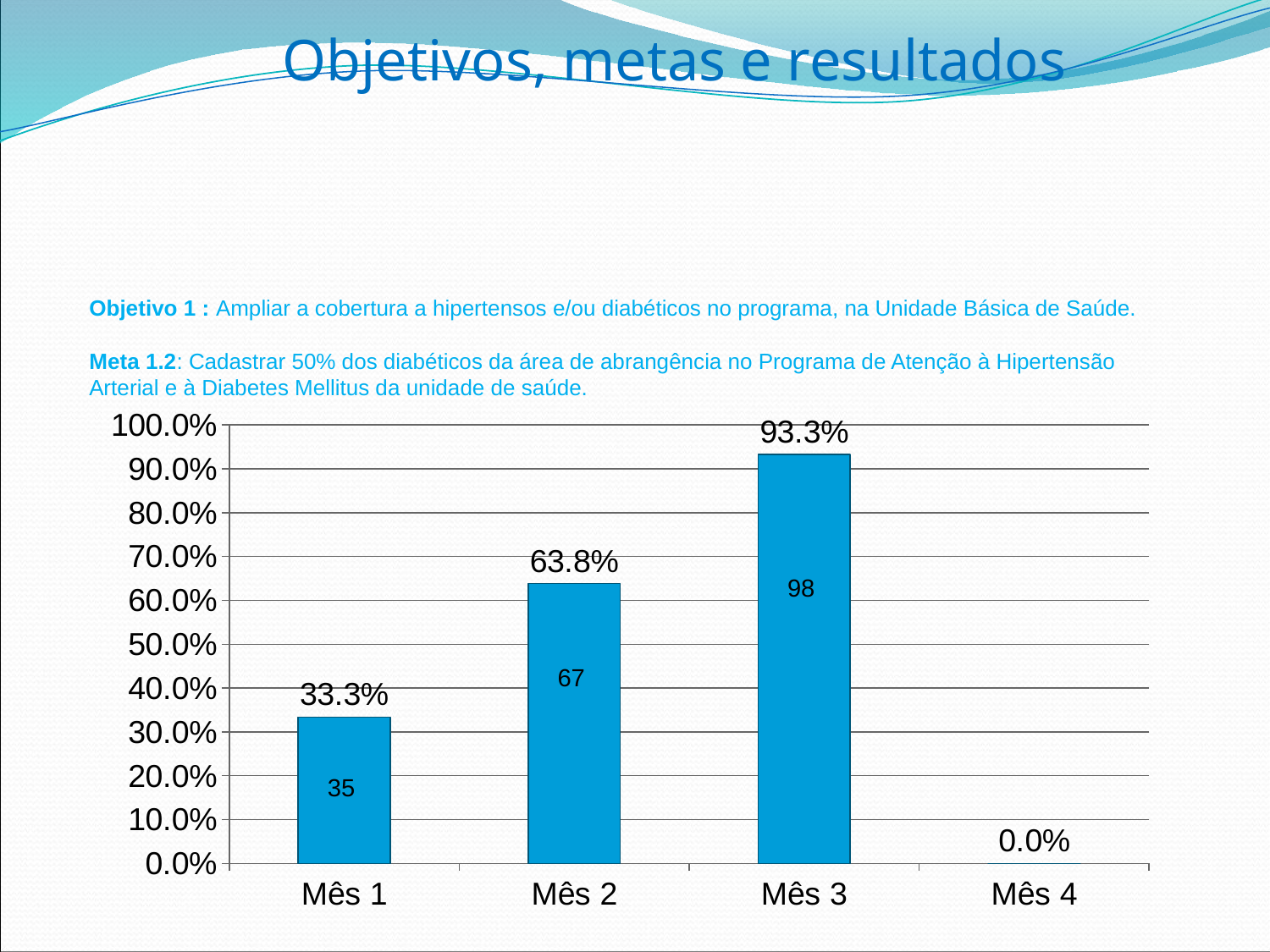
Which month has the highest percentage value? Mês 3 What is the percentage value shown for Mês 3? 93.3% What kind of chart is shown on the slide? Bar chart What number is printed inside the bar for Mês 1? 35 Which is larger, the value for Mês 2 or the value for Mês 1? Mês 2 Which month has the lowest percentage value? Mês 4 What is the percentage value shown for Mês 1? 33.3% What is the percentage value shown for Mês 4? 0.0% How many months (categories) are shown on the x axis? 4 What number is printed inside the bar for Mês 3? 98 What is the difference in percentage points between Mês 3 and Mês 1? 60.0% What is the percentage value shown for Mês 2? 63.8%